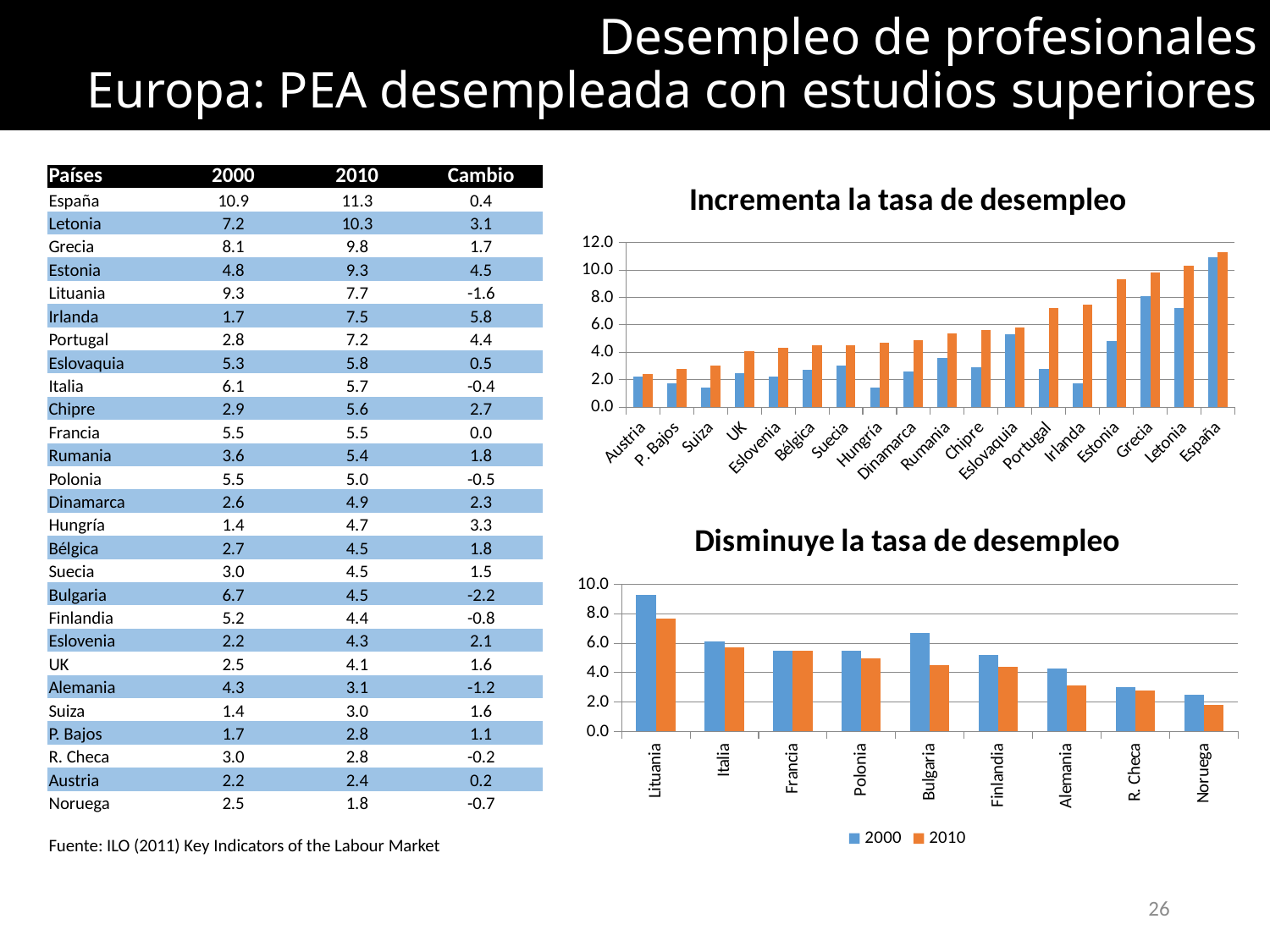
How many series does the legend of the 'Disminuye la tasa de desempleo' chart list? 2 In the 'Disminuye la tasa de desempleo' chart, by how much is Lituania's 2010 value lower than its 2000 value? 1.6 How many countries are shown in the 'Incrementa la tasa de desempleo' chart? 18 In the 'Incrementa la tasa de desempleo' chart, which country has the highest 2010 value? España What kind of chart is 'Incrementa la tasa de desempleo'? bar chart In the 'Incrementa la tasa de desempleo' chart, is the 2010 value for Letonia greater or less than 8.0? greater In the 'Disminuye la tasa de desempleo' chart, which country has the lowest 2010 value? Noruega In the 'Incrementa la tasa de desempleo' chart, do the 2010 values rise or fall from left to right along the x axis? rise In the 'Disminuye la tasa de desempleo' chart, is the 2000 value for Lituania greater or less than 8.0? greater In the 'Incrementa la tasa de desempleo' chart, what is the 2010 value for Irlanda? 7.5 How many countries are shown in the 'Disminuye la tasa de desempleo' chart? 9 In the 'Disminuye la tasa de desempleo' chart, which is larger for Bulgaria: the 2000 value or the 2010 value? 2000